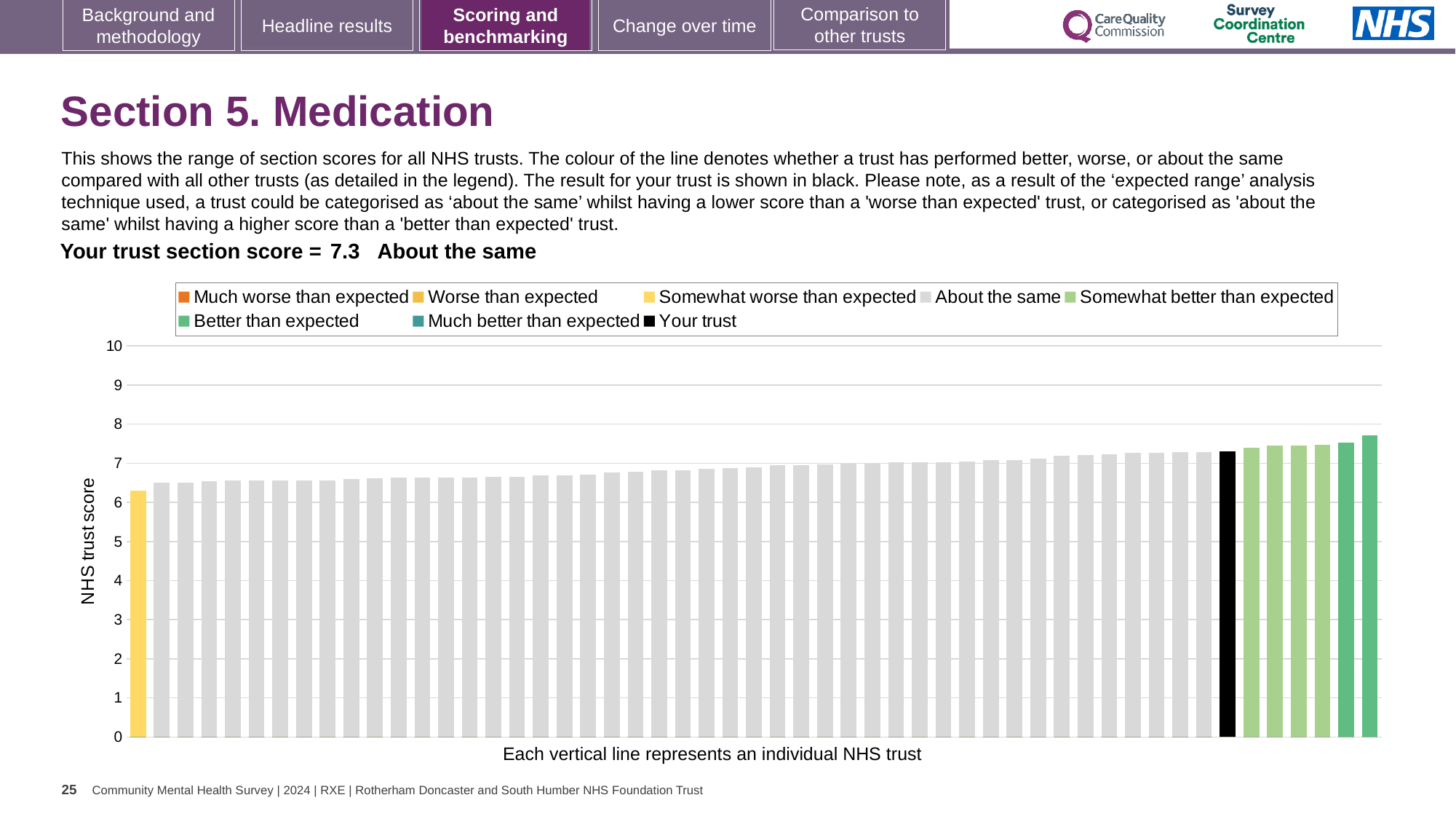
Is the value for the black 'Your trust' bar greater or less than 7? greater Do the bar values rise or fall from left to right along the x axis? rise Is the value for the leftmost (yellow) bar greater or less than 7? less How many entries does the chart legend list? 8 Which benchmarking category is the trust's section score placed in? About the same What kind of chart is shown on the slide? bar chart Which is higher, the leftmost bar or the rightmost bar? the rightmost bar Is the value for the black 'Your trust' bar greater or less than 8? less What colour is used for the 'Your trust' bar in the chart? black What is the trust's section score for Section 5. Medication? 7.3 What is the label on the vertical axis of the chart? NHS trust score